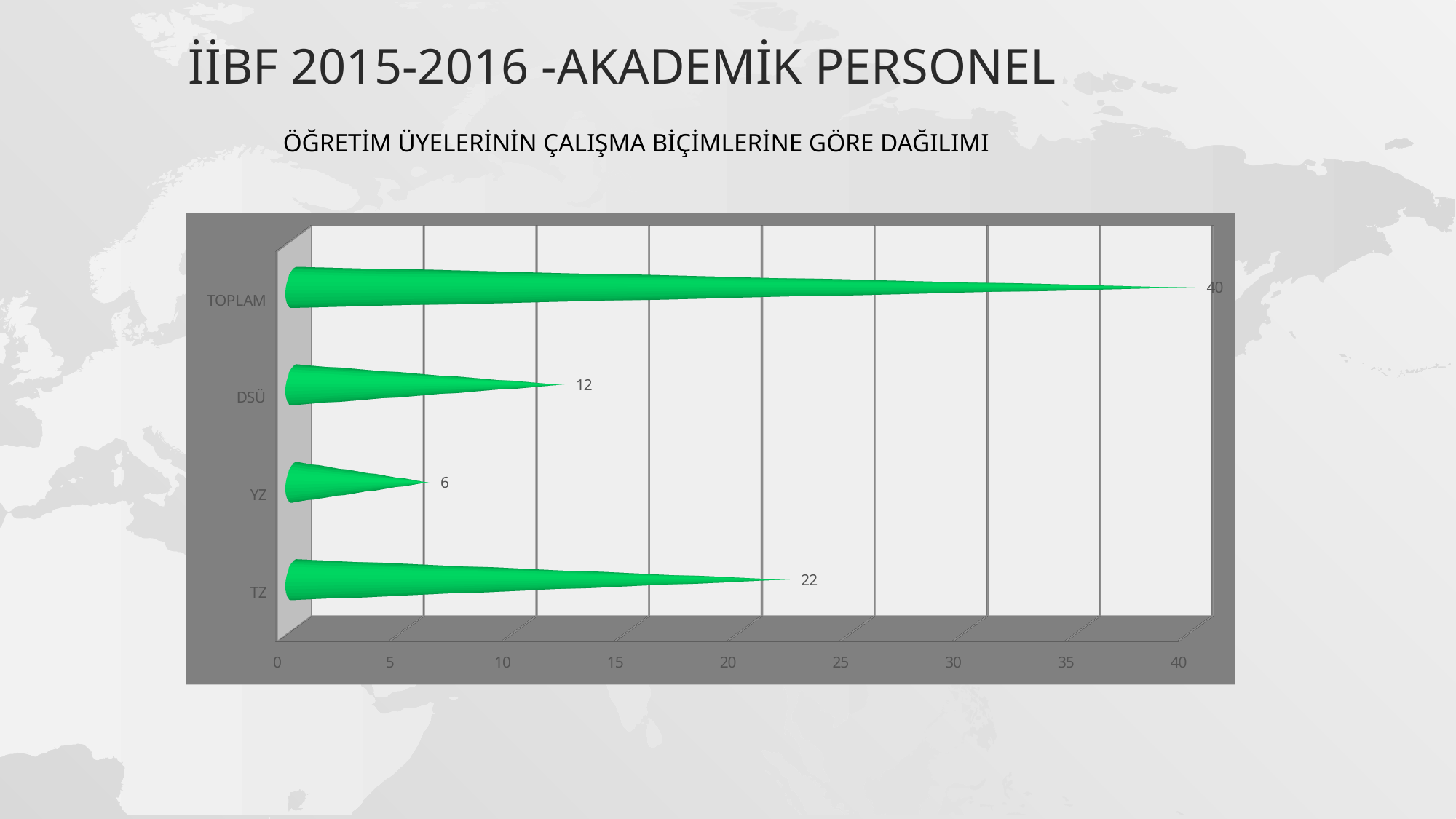
How many categories are shown on the chart? 4 Is the value for DSÜ greater or less than 10? greater What is the value for DSÜ? 12 What is the difference between the values for TZ and DSÜ? 10 What is the value for TZ? 22 What is the value for TOPLAM? 40 What kind of chart is shown on the slide? bar chart What is the difference between the values for TOPLAM and TZ? 18 Which category has the highest value? TOPLAM Which category has the lowest value? YZ What is the value for YZ? 6 Which is larger, the value for TZ or the value for DSÜ? TZ